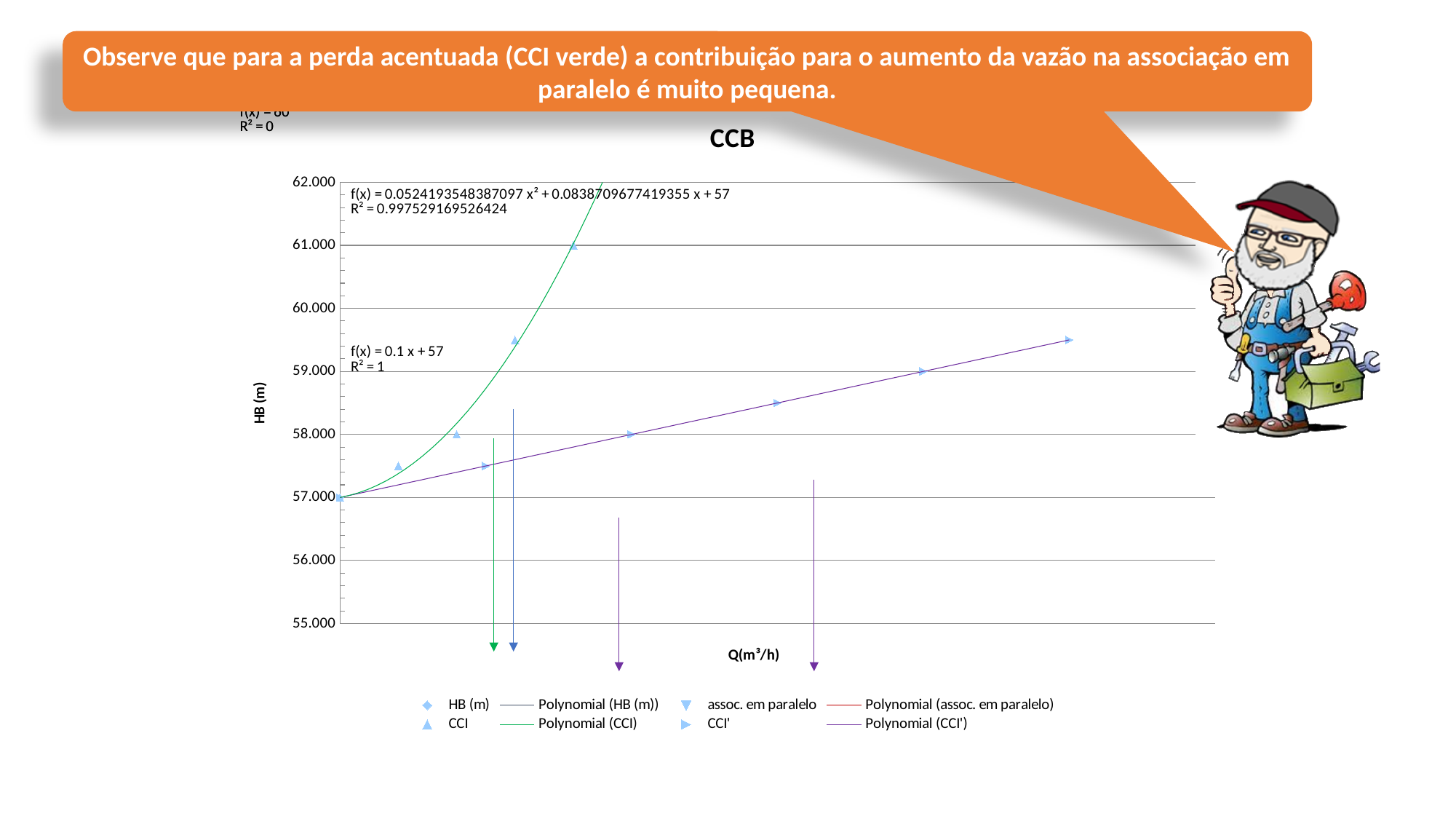
What is the title of the chart? CCB Do the CCI values rise or fall as Q increases along the x axis? Rise How many entries does the chart legend list? 8 How many CCI' data points are plotted on the chart? 6 Do the CCI' values rise or fall as Q increases along the x axis? Rise Is the highest plotted CCI' value greater or less than 60.000? less Is the highest plotted CCI value greater or less than 60.000? greater What is the highest tick value shown on the vertical axis? 62.000 Which series reaches a higher maximum HB value, CCI or CCI'? CCI What R² value is shown for the linear trendline f(x) = 0.1 x + 57? 1 What kind of chart is shown on the slide? Scatter chart What is the label on the vertical axis of the chart? HB (m)